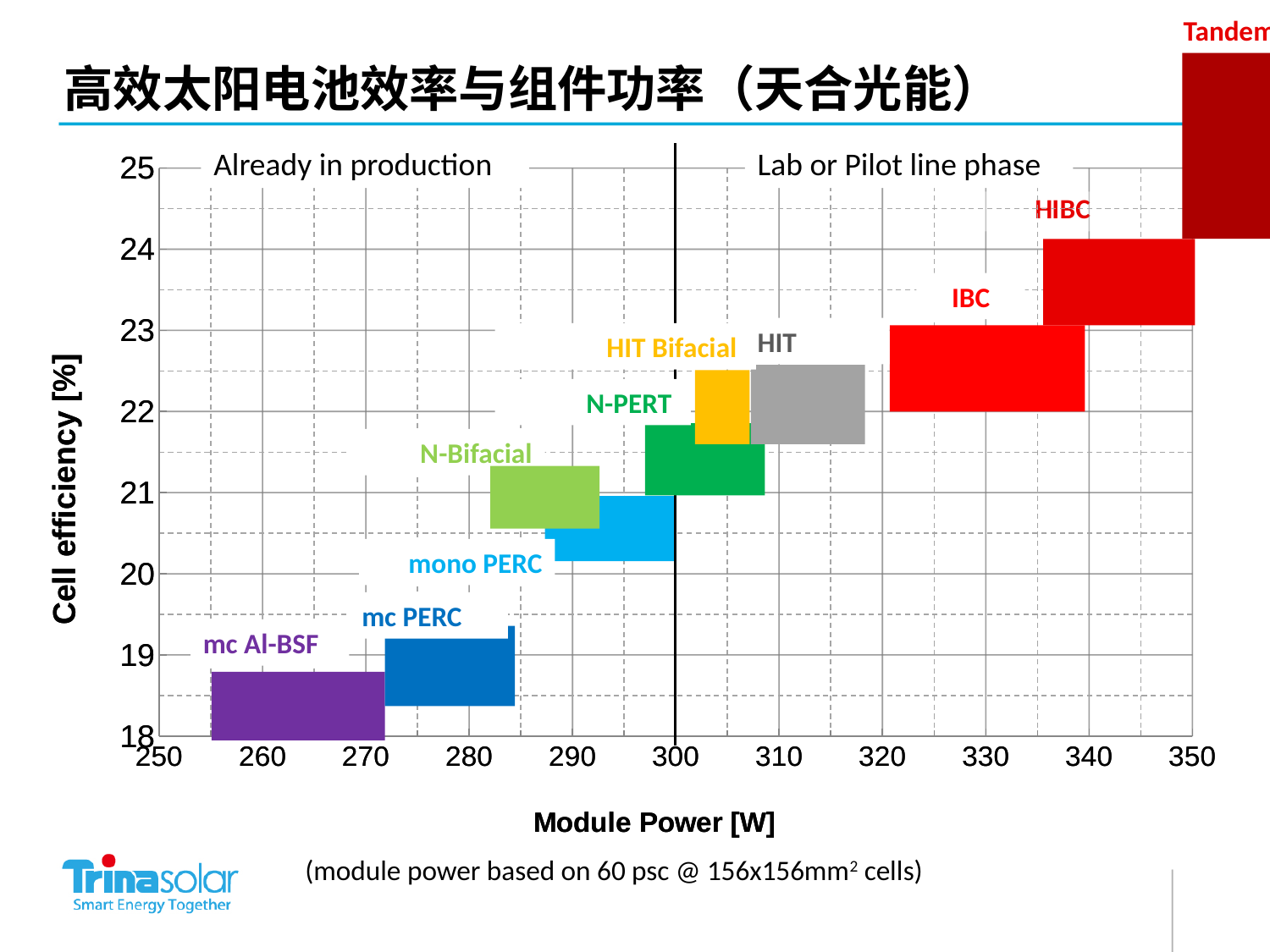
Is the cell efficiency for mc Al-BSF greater or less than 19%? less What is the title of the y axis of the chart? Cell efficiency [%] Is the cell efficiency for HIBC greater or less than 23%? greater Is the module power for mc Al-BSF greater or less than 280 W? less How many cell technologies are labelled on the chart? 10 Which cell technology has the lowest cell efficiency on the chart? mc Al-BSF Which has the higher module power, IBC or mono PERC? IBC What is the title of the x axis of the chart? Module Power [W] Which has the higher cell efficiency, HIBC or mc PERC? HIBC Which cell technology has the highest cell efficiency on the chart? Tandem